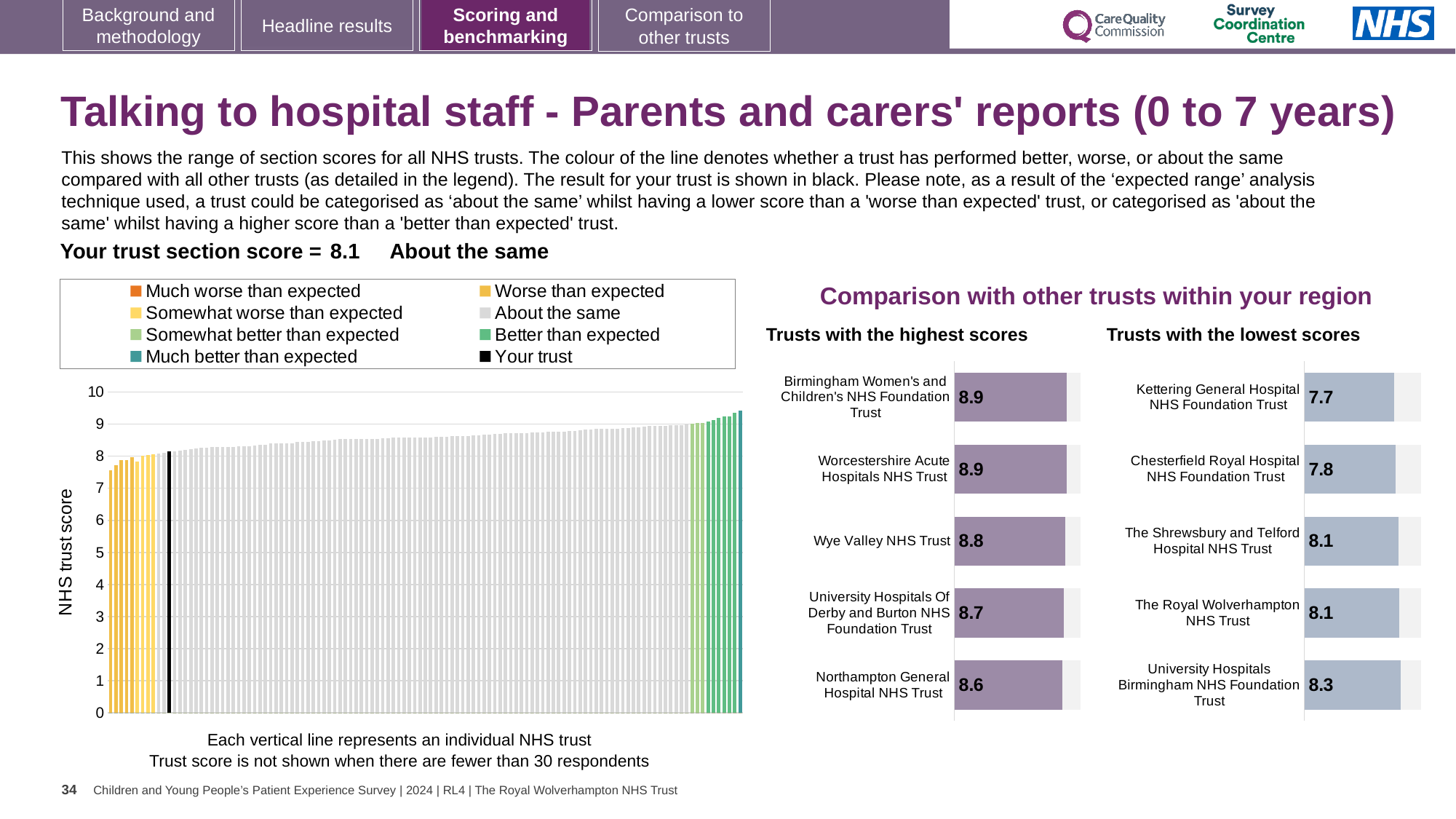
In the 'Trusts with the highest scores' chart, what is the score for Wye Valley NHS Trust? 8.8 In the 'Trusts with the highest scores' chart, what is the difference between the scores of Birmingham Women's and Children's NHS Foundation Trust and Northampton General Hospital NHS Trust? 0.3 In the 'Trusts with the highest scores' chart, which trust has the lowest score shown? Northampton General Hospital NHS Trust In the 'Trusts with the lowest scores' chart, which trust has the highest score shown? University Hospitals Birmingham NHS Foundation Trust In the NHS trust score chart on the left, do the trust scores rise or fall from left to right? rise In the 'Trusts with the lowest scores' chart, what is the score for Kettering General Hospital NHS Foundation Trust? 7.7 How many trusts are listed in the 'Trusts with the highest scores' chart? 5 In the NHS trust score chart on the left, what is the section score for your trust (the black line)? 8.1 How many entries does the legend of the NHS trust score chart on the left list? 8 In the 'Trusts with the lowest scores' chart, which has the larger score: Chesterfield Royal Hospital NHS Foundation Trust or The Shrewsbury and Telford Hospital NHS Trust? The Shrewsbury and Telford Hospital NHS Trust In the 'Trusts with the lowest scores' chart, what is the score for The Royal Wolverhampton NHS Trust? 8.1 In the 'Trusts with the lowest scores' chart, what is the difference between the scores of University Hospitals Birmingham NHS Foundation Trust and Kettering General Hospital NHS Foundation Trust? 0.6